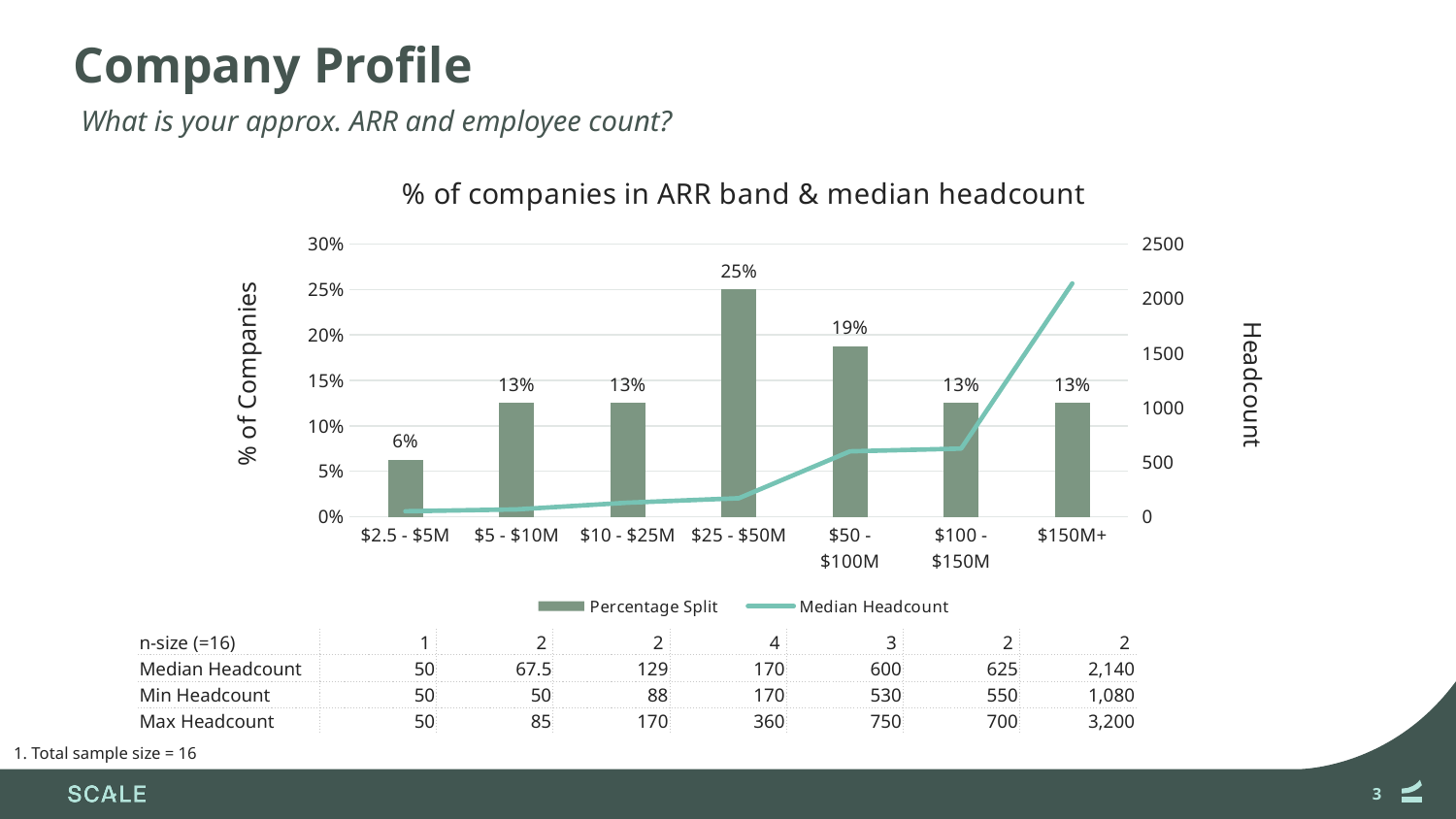
Is the median headcount for the $150M+ ARR band greater or less than 2000? greater Which ARR band has the highest percentage of companies? $25 - $50M What percentage of companies are in the $2.5 - $5M ARR band? 6% How many ARR bands are shown on the x axis? 7 Does the median headcount line rise or fall as ARR band increases along the x axis? rises Which ARR band has the lowest percentage of companies? $2.5 - $5M What is the title of the chart? % of companies in ARR band & median headcount What percentage of companies are in the $25 - $50M ARR band? 25% Is the median headcount for the $25 - $50M ARR band greater or less than 500? less Which has a larger percentage of companies, the $50 - $100M band or the $100 - $150M band? $50 - $100M What is the difference in percentage of companies between the $25 - $50M band and the $50 - $100M band? 6% How many series does the legend list? 2